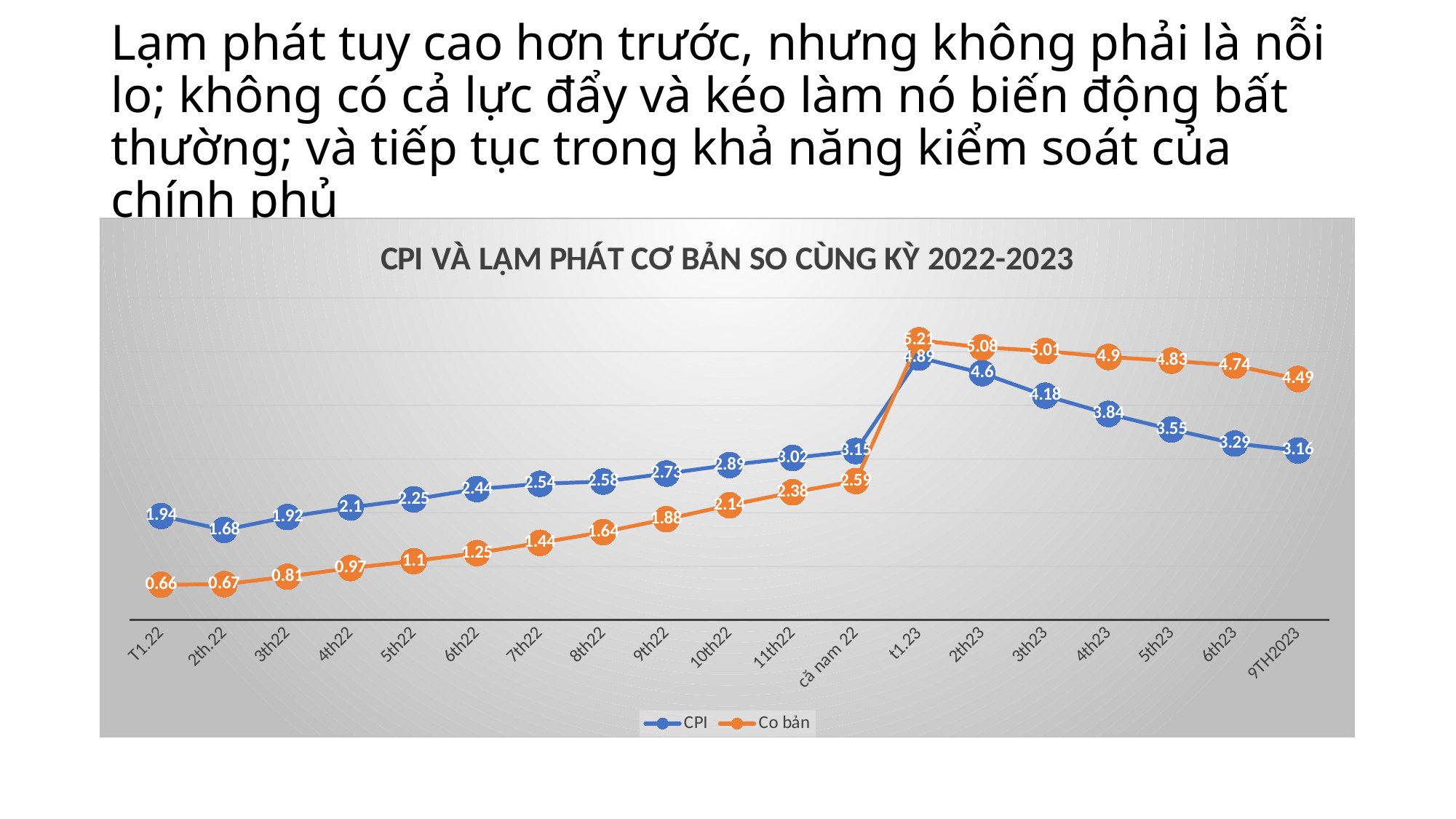
Does the CPI series rise or fall from t1.23 to 9TH2023? Fall What is the Cơ bản value for t1.23? 5.21 At which category does the CPI series reach its highest value? t1.23 At 6th22, which series has the larger value, CPI or Cơ bản? CPI How many categories are shown on the x axis? 19 What is the CPI value for 9TH2023? 3.16 What is the title of the chart? CPI VÀ LẠM PHÁT CƠ BẢN SO CÙNG KỲ 2022-2023 What is the CPI value for 2th.22? 1.68 How many series does the legend list? 2 What kind of chart is shown on the slide? Line chart At which category is the Cơ bản series lowest? T1.22 What is the difference between the Cơ bản value and the CPI value at 9TH2023? 1.33